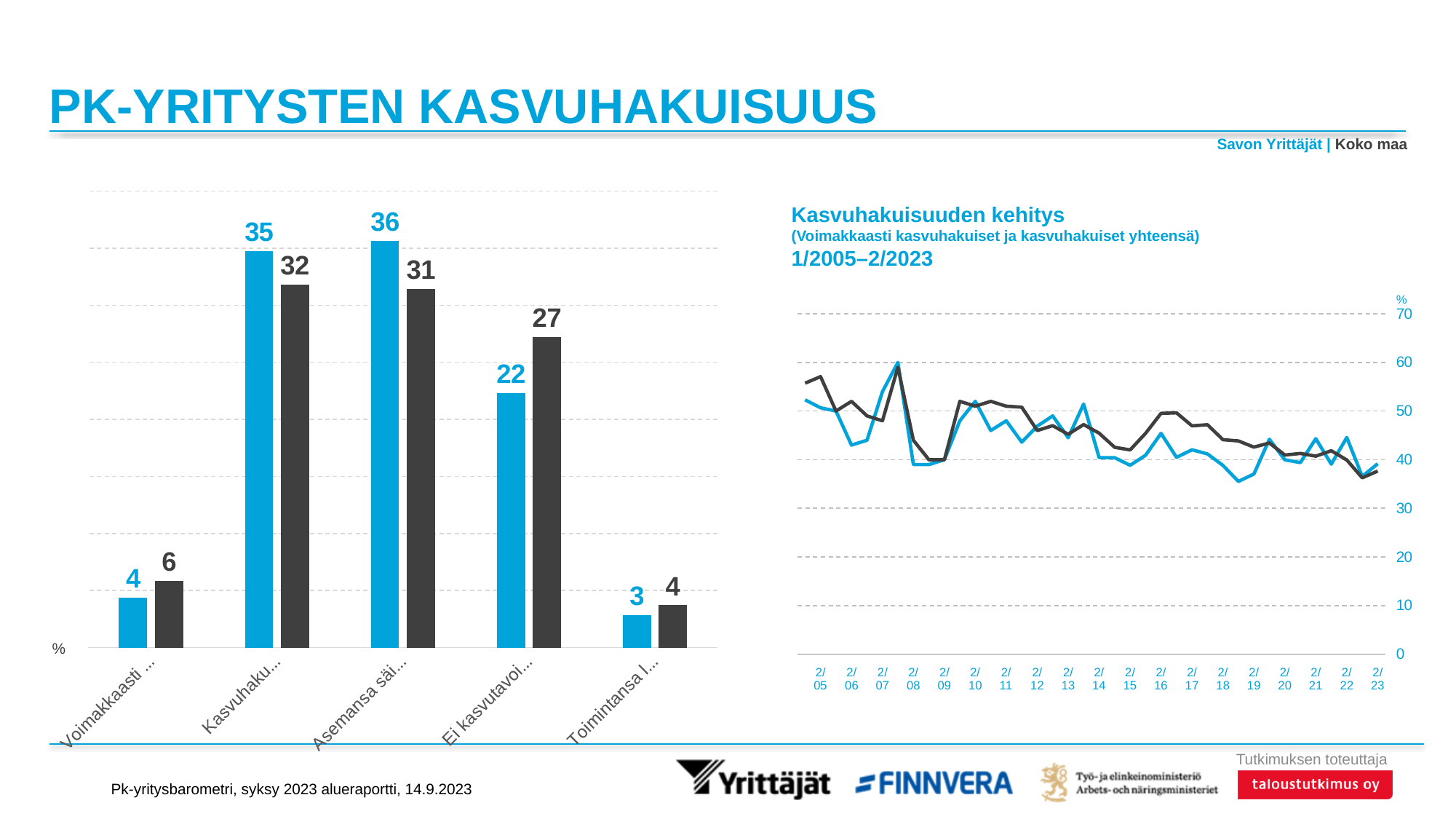
How many series does the legend of the bar chart on the left list? 2 In the bar chart on the left, what is the Savon Yrittäjät value for the category labelled "Kasvuhaku..."? 35 What kind of chart is the chart on the left of the slide? bar chart How many categories are shown in the bar chart on the left? 5 In the bar chart on the left, for the category "Asemansa säi...", which series has the larger value, Savon Yrittäjät or Koko maa? Savon Yrittäjät In the bar chart on the left, what is the difference between the Koko maa and Savon Yrittäjät values for the category "Ei kasvutavoi..."? 5 In the chart "Kasvuhakuisuuden kehitys", do the values generally rise or fall from 2/05 to 2/23? fall In the chart "Kasvuhakuisuuden kehitys", is the value of the blue line at 2/23 greater or less than 50? less In the bar chart on the left, which category has the lowest Koko maa value? Toimintansa l... In the bar chart on the left, what is the Koko maa value for the category labelled "Ei kasvutavoi..."? 27 What kind of chart is "Kasvuhakuisuuden kehitys" on the right of the slide? line chart In the bar chart on the left, which category has the highest Savon Yrittäjät value? Asemansa säi...